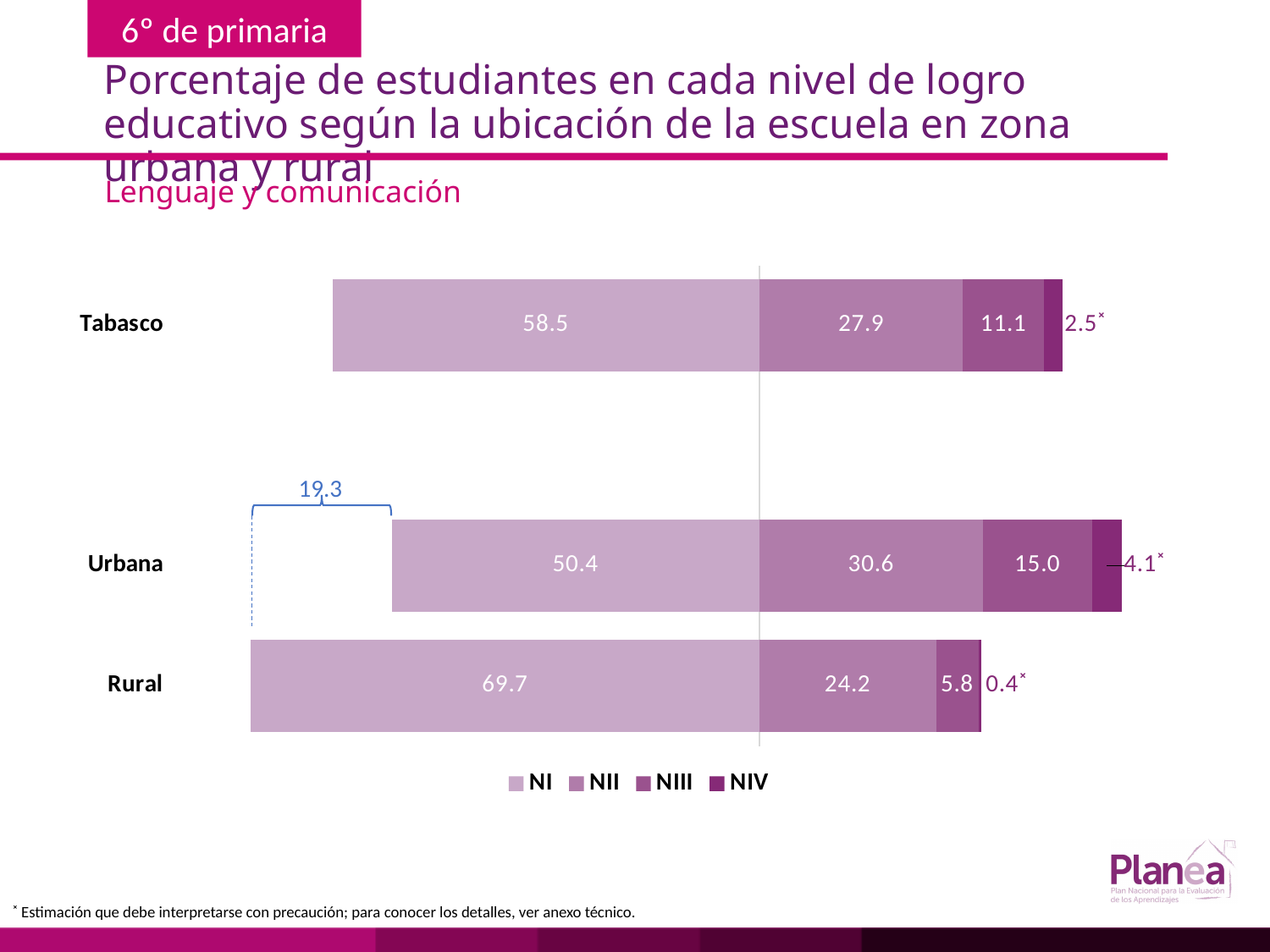
Which is larger, the NII value for Urbana or for Rural? Urbana What percentage of Urbana students are at level NIII? 15.0 Which category has the lowest NIV percentage? Rural What is the NIV value for Rural schools? 0.4 What kind of chart is shown on the slide? Stacked bar chart What is the NII value for Tabasco? 27.9 What percentage of Rural students are at level NI? 69.7 How many categories are shown on the chart? 3 How many series does the legend list? 4 What is the difference between the NIII values for Urbana and Rural? 9.2 Which category has the highest NI percentage? Rural What is the difference between the NI values for Rural and Urbana? 19.3